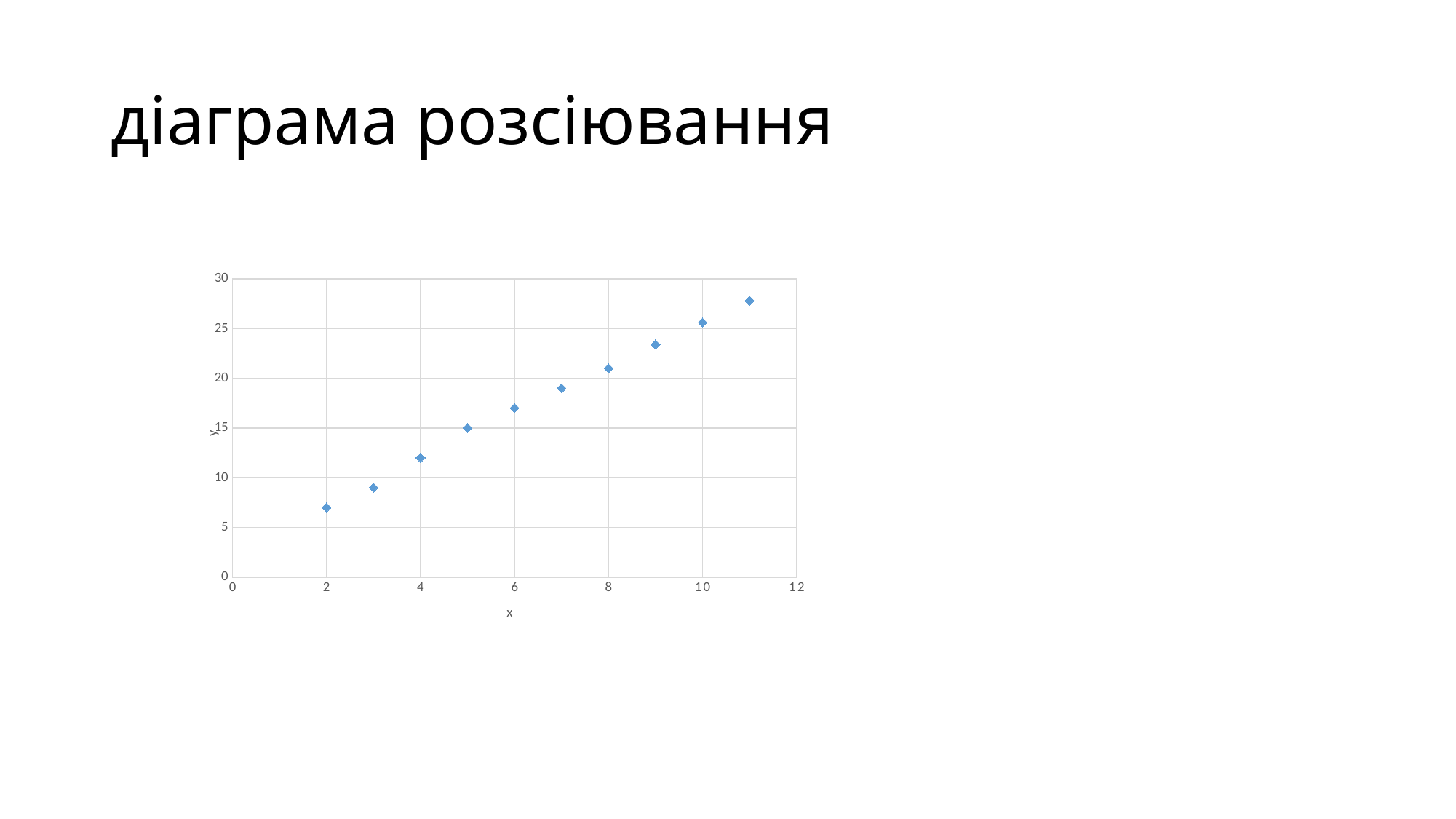
At which x value is the highest y value plotted? 11 Is the y value at x = 2 greater or less than 10? less What is the title of the slide above the chart? діаграма розсіювання At which x value is the lowest y value plotted? 2 What is the label of the horizontal axis? x What kind of chart is shown on the slide? scatter chart How many data points are plotted on the chart? 10 Which has the larger y value: the point at x = 6 or the point at x = 9? x = 9 Is the y value at x = 4 greater or less than 15? less Is the y value at x = 11 greater or less than 25? greater Do the y values rise or fall as x increases? rise